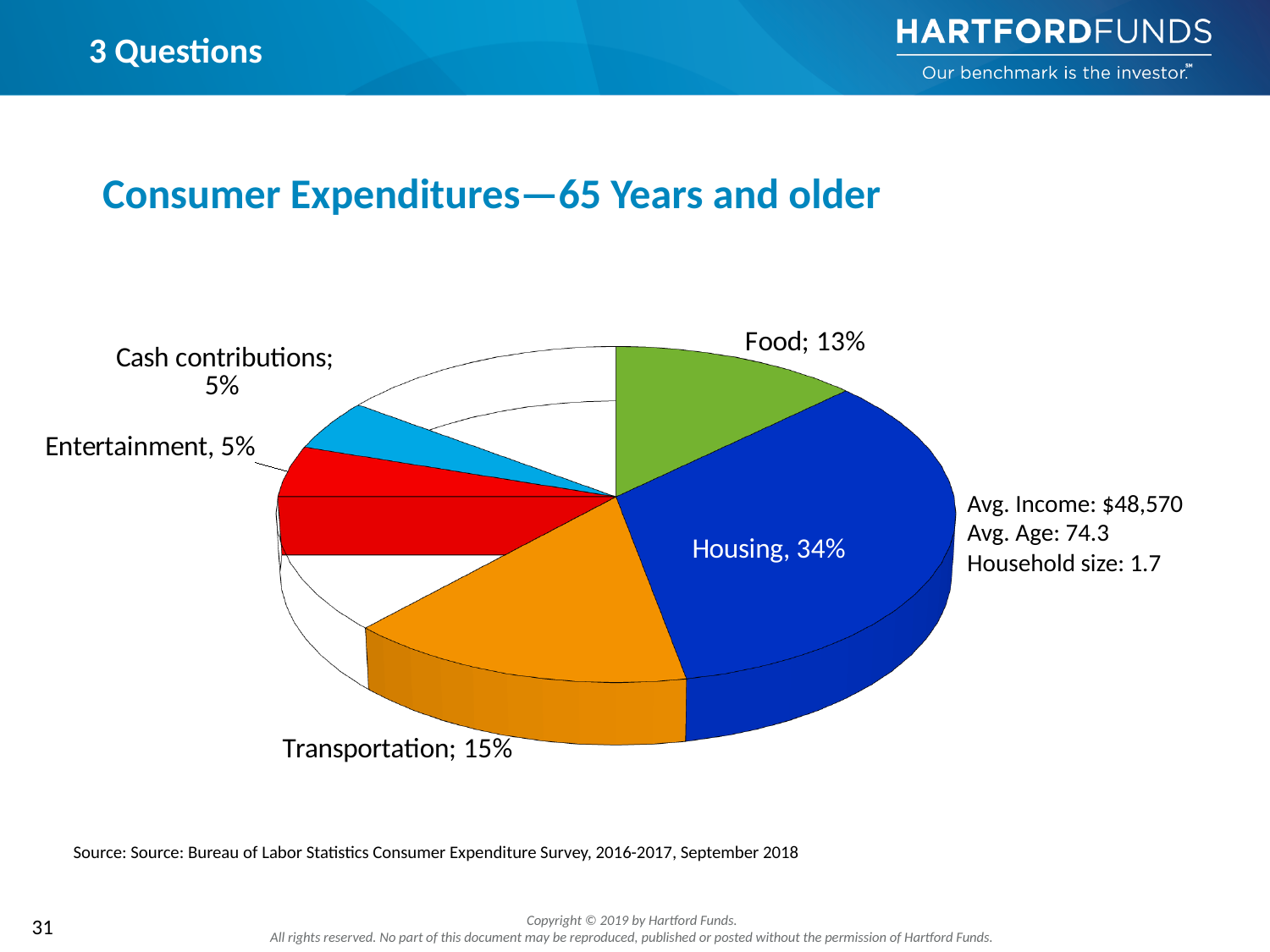
Which is larger, the share for Food or the share for Transportation? Transportation What percentage is shown for Cash contributions? 5% What percentage is shown for Transportation? 15% What colour is the Housing slice of the pie? Blue What kind of chart is shown on the slide? Pie chart What is the difference in percentage points between Transportation and Food? 2 percentage points What share of expenditures does Housing account for? 34% What percentage is shown for Entertainment? 5% What percentage is shown for Food? 13% What is the title of the chart? Consumer Expenditures—65 Years and older Which labeled category has the largest share of the pie? Housing What is the difference in percentage points between Housing and Food? 21 percentage points